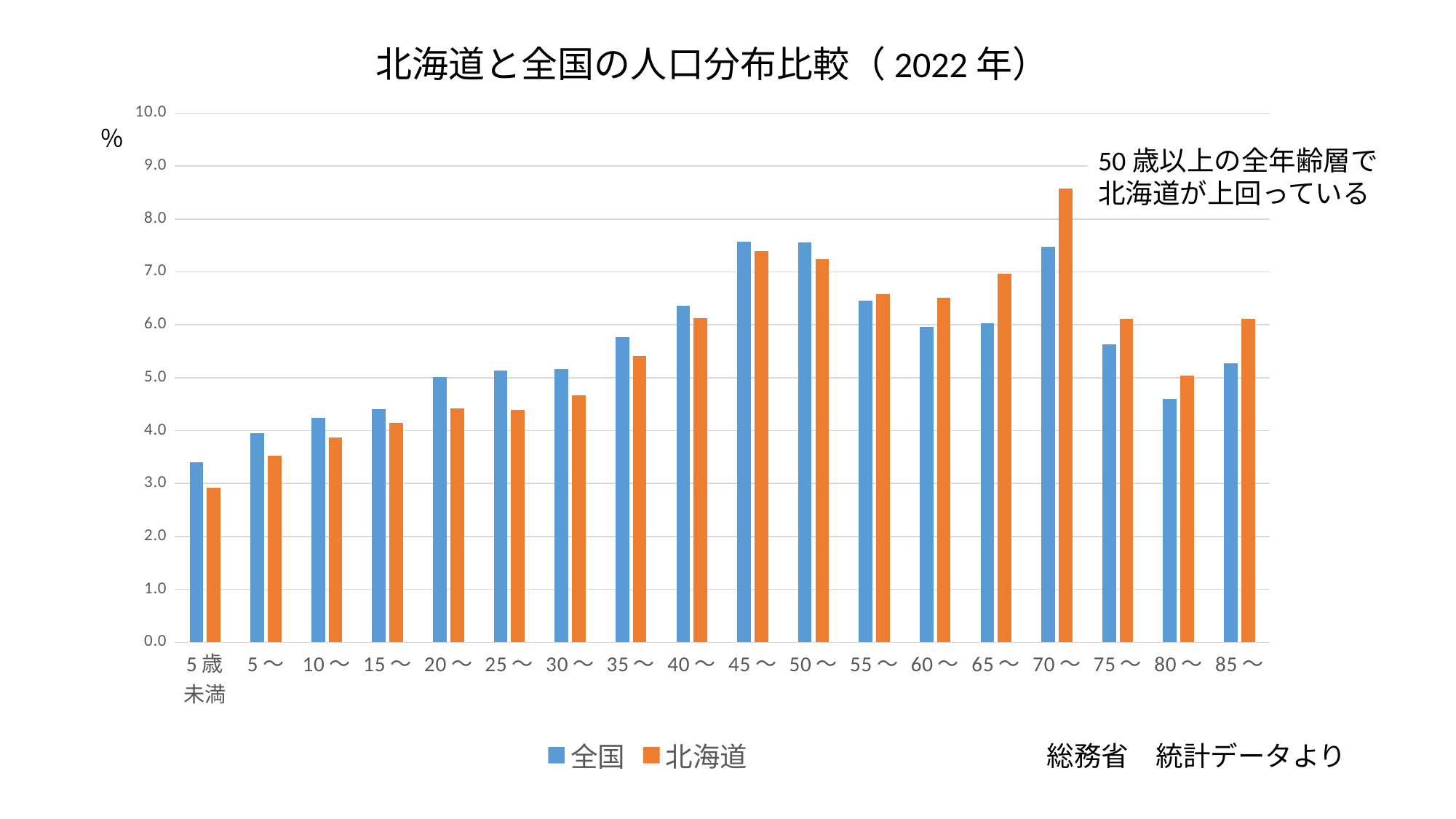
At 35～, which series has the larger value, 全国 or 北海道? 全国 Which age category has the highest value for 北海道? 70～ Is the value for 全国 at 80～ greater or less than 5.0? less How many series does the legend list? 2 What kind of chart is shown on the slide? bar chart Which age category has the lowest value for 全国? 5歳未満 What is the title of the chart? 北海道と全国の人口分布比較（2022年） Is the value for 北海道 at 70～ greater or less than 8.0? greater Is the value for 北海道 at 5歳未満 greater or less than 3.0? less How many age categories are shown on the x axis? 18 At 70～, which series has the larger value, 全国 or 北海道? 北海道